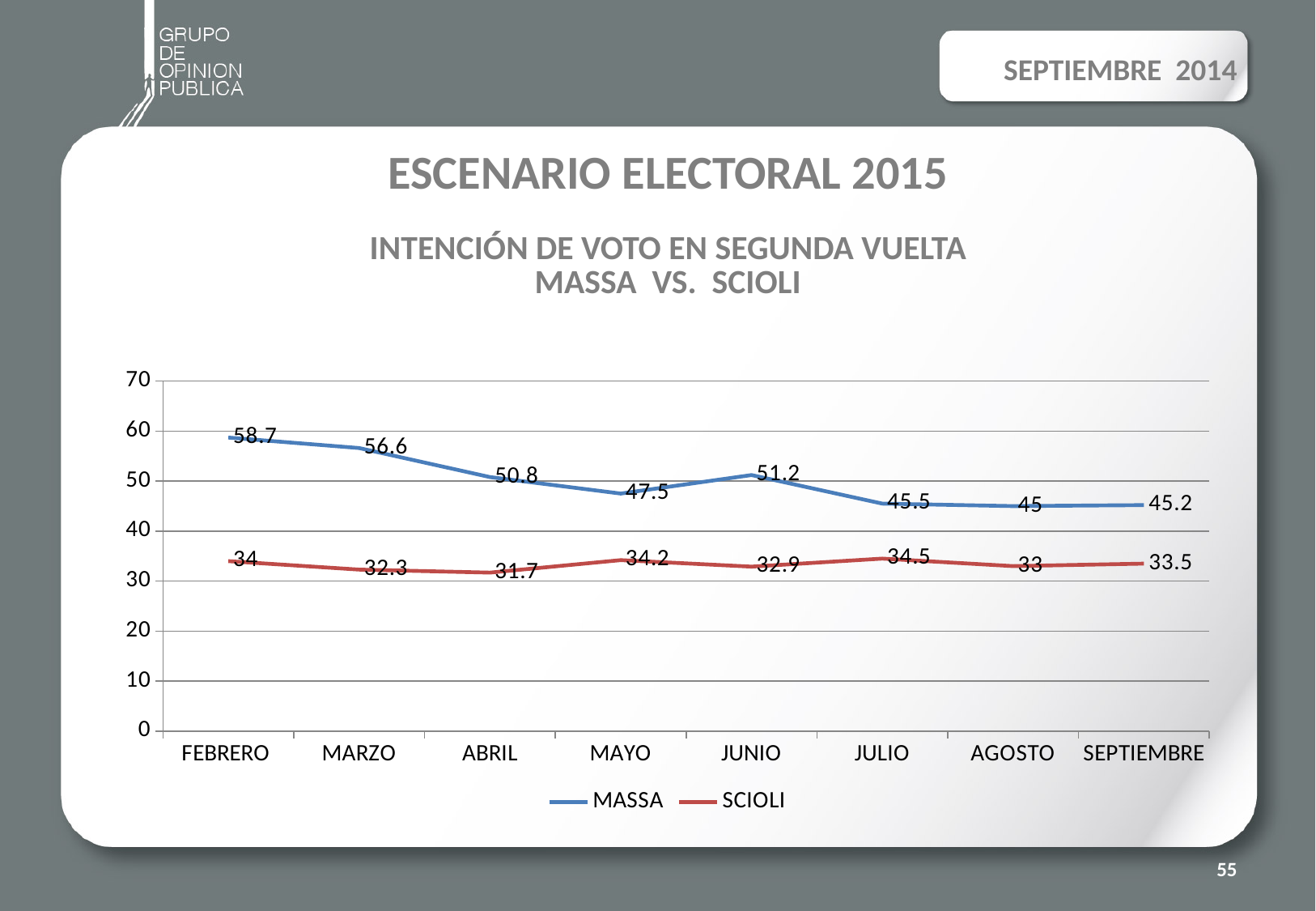
What is the value for MASSA in FEBRERO? 58.7 What is the value for MASSA in SEPTIEMBRE? 45.2 Does the MASSA line generally rise or fall from FEBRERO to SEPTIEMBRE? fall How many months are shown on the x axis? 8 How many series does the legend list? 2 Which is larger in JUNIO, the MASSA value or the SCIOLI value? MASSA In which month is the SCIOLI value lowest? ABRIL In which month is the MASSA value highest? FEBRERO What is the difference between MASSA and SCIOLI in MAYO? 13.3 What is the value for SCIOLI in JULIO? 34.5 What kind of chart is shown on the slide? line chart What is the value for SCIOLI in ABRIL? 31.7